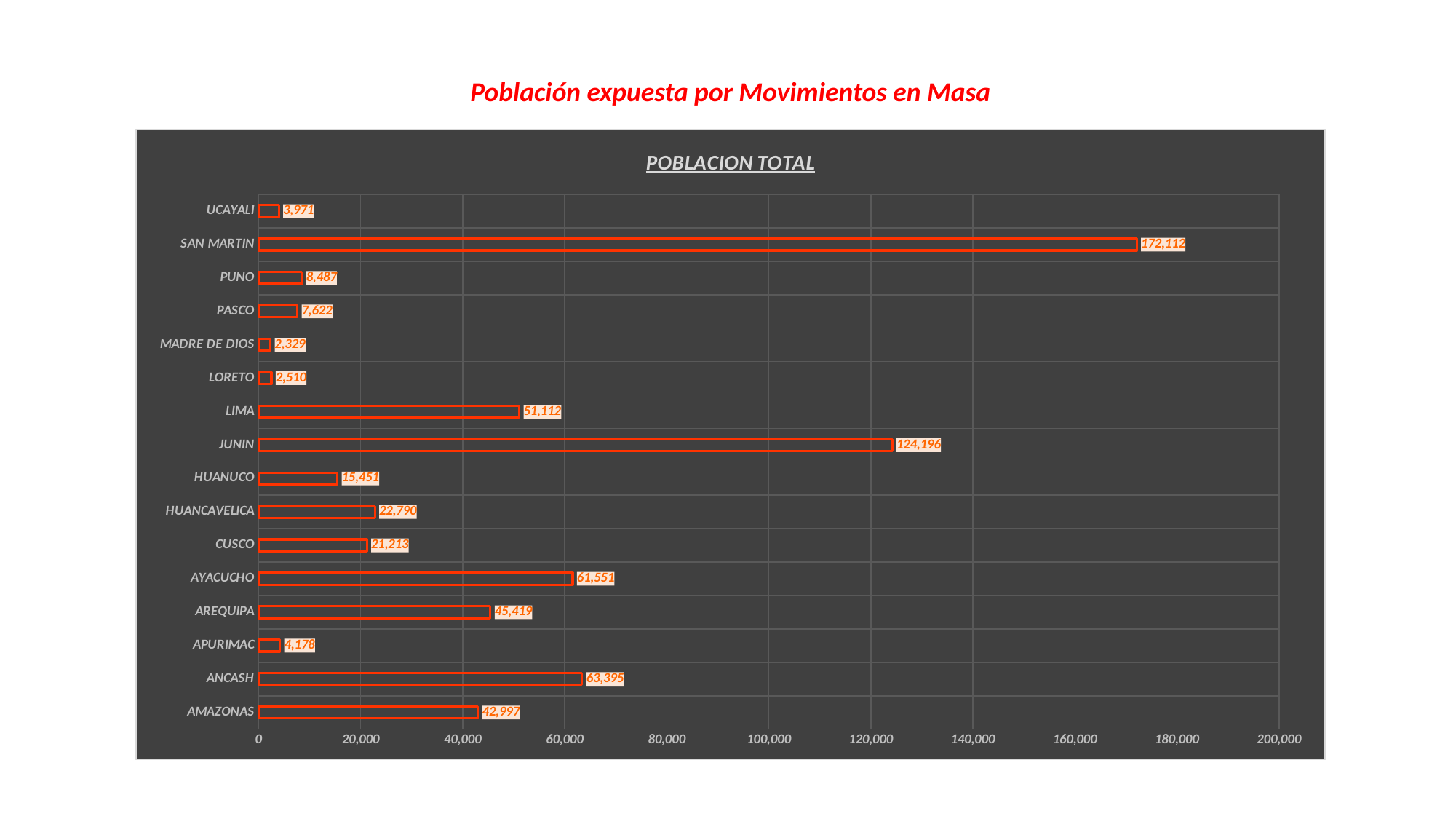
What is the difference between the values for SAN MARTIN and JUNIN? 47,916 Which category has the lowest value? MADRE DE DIOS What is the difference between the values for ANCASH and AYACUCHO? 1,844 What is the value for JUNIN? 124,196 Is the value for JUNIN greater or less than 100,000? greater What is the value for HUANCAVELICA? 22,790 How many categories are shown in the chart? 16 What is the value for AMAZONAS? 42,997 Which category has the highest value? SAN MARTIN Which is larger, the value for LIMA or the value for AREQUIPA? LIMA What is the value for SAN MARTIN? 172,112 What kind of chart is shown on the slide? Bar chart